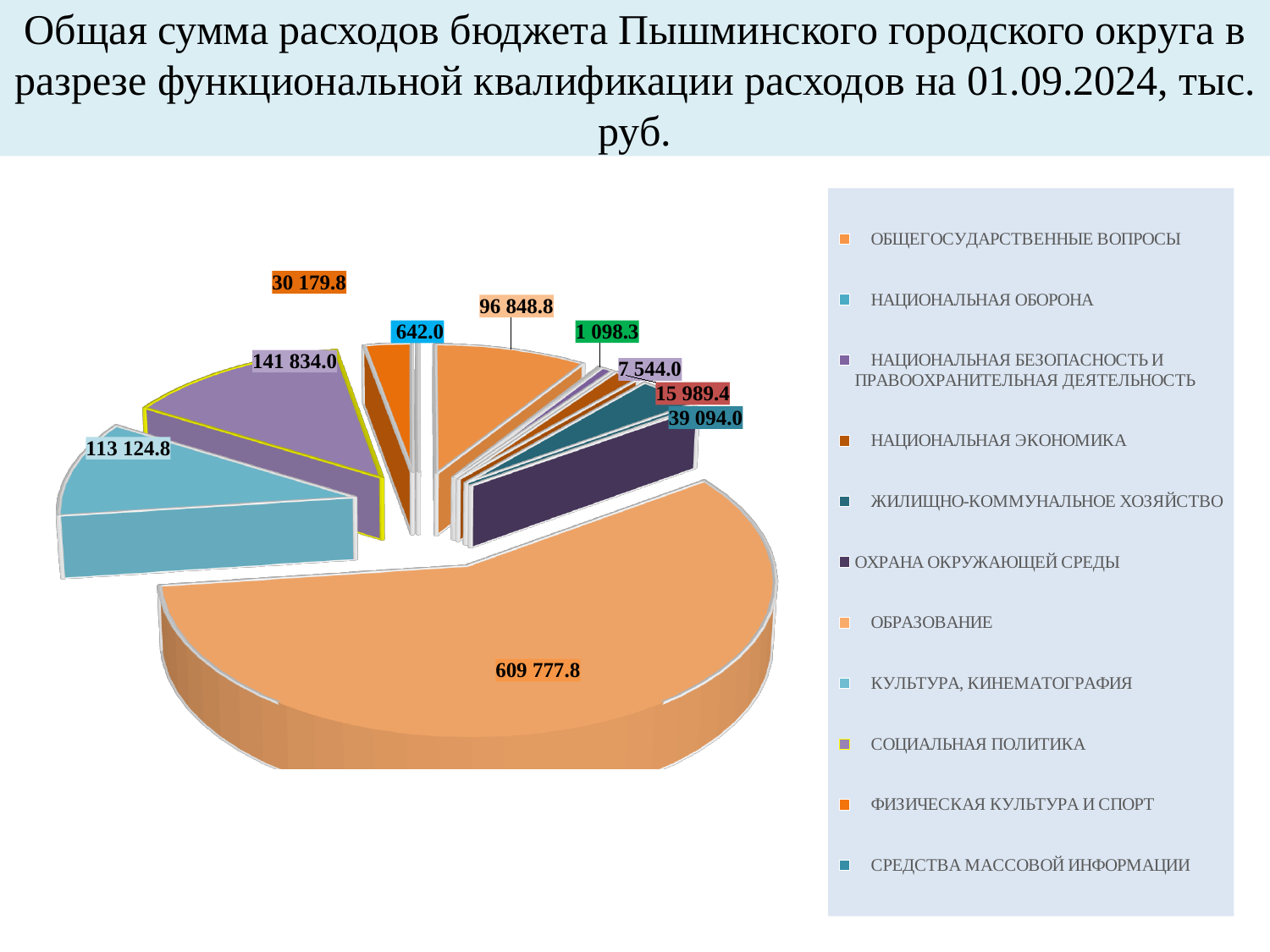
In what units are the values on the chart expressed, according to the slide title? тыс. руб. What is the difference between the values for СОЦИАЛЬНАЯ ПОЛИТИКА and КУЛЬТУРА, КИНЕМАТОГРАФИЯ? 28 709.2 Which is larger: the value for СОЦИАЛЬНАЯ ПОЛИТИКА or the value for КУЛЬТУРА, КИНЕМАТОГРАФИЯ? СОЦИАЛЬНАЯ ПОЛИТИКА What is the value for СОЦИАЛЬНАЯ ПОЛИТИКА? 141 834.0 What is the smallest value labelled on the pie chart? 642.0 What is the value for ОБРАЗОВАНИЕ? 609 777.8 What is the value for НАЦИОНАЛЬНАЯ ОБОРОНА? 1 098.3 What is the value for КУЛЬТУРА, КИНЕМАТОГРАФИЯ? 113 124.8 What is the largest value shown on the pie chart? 609 777.8 Which category has the largest slice of the pie chart? ОБРАЗОВАНИЕ How many categories does the legend of the pie chart list? 11 What type of chart is shown on the slide? Pie chart